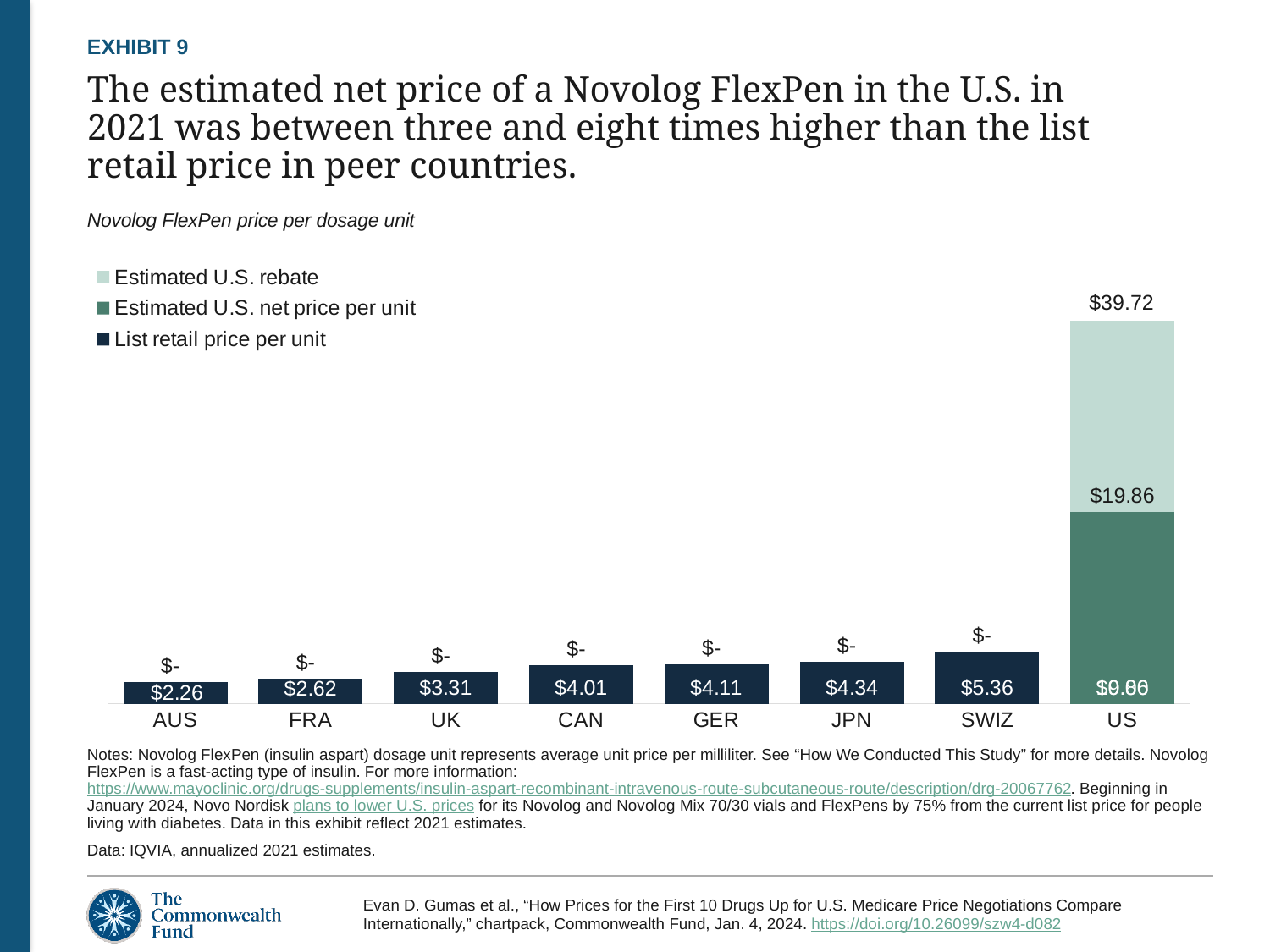
What is the list retail price per unit for AUS? $2.26 Among the seven non-U.S. countries, which has the highest list retail price per unit? SWIZ Among the seven non-U.S. countries, which has the lowest list retail price per unit? AUS What kind of chart is shown on the slide? Bar chart What is the list retail price per unit for SWIZ? $5.36 How many series does the chart legend list? 3 Do the list retail prices per unit rise or fall from AUS to SWIZ along the x axis? Rise What is the estimated U.S. net price per unit shown for the US bar? $19.86 What is the difference between the list retail price per unit for SWIZ and for AUS? $3.10 How many countries are shown on the x axis of the chart? 8 Which has the higher list retail price per unit, CAN or GER? GER What value is labeled at the top of the US bar? $39.72